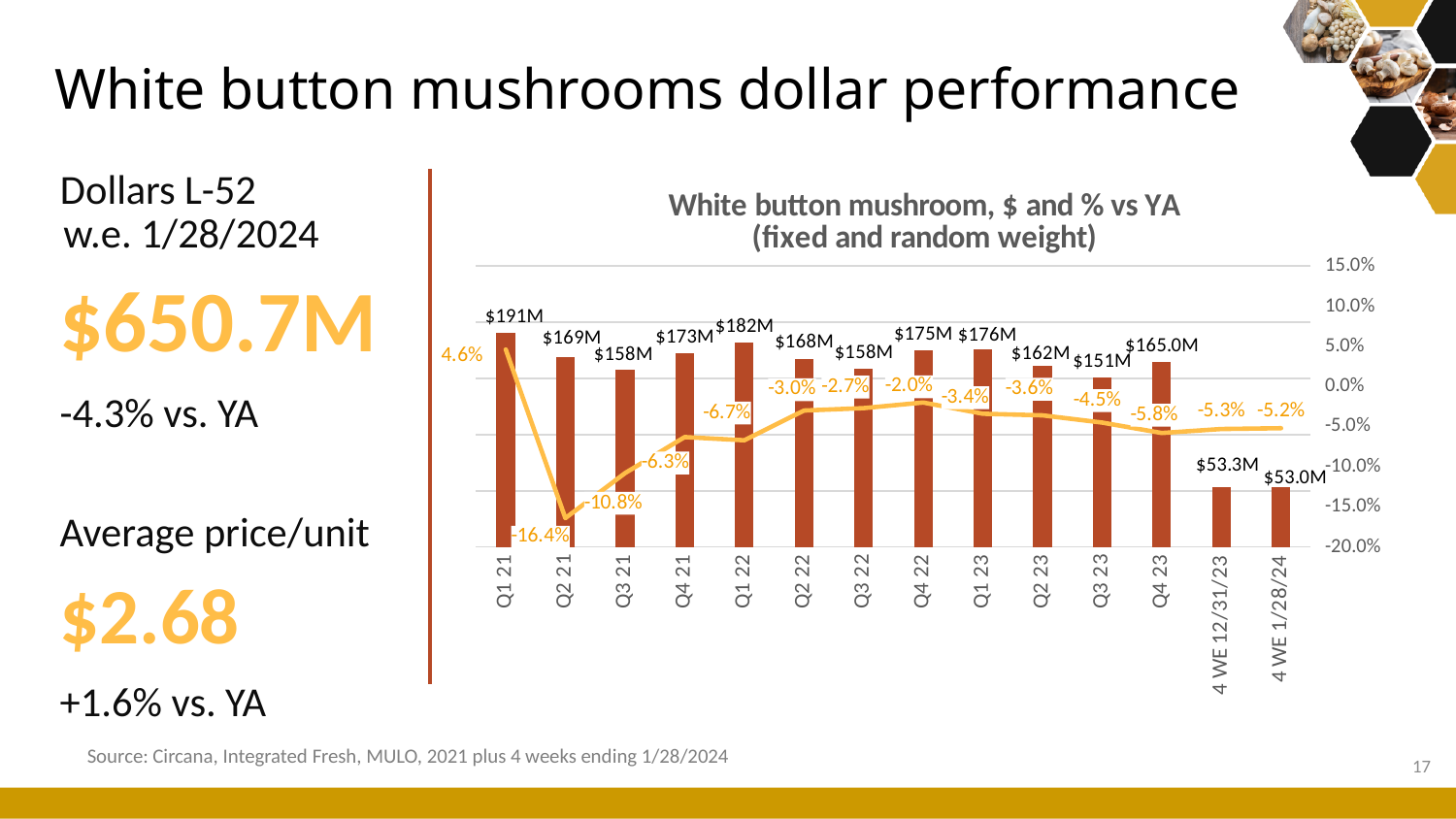
What is the dollar value for Q4 23 in the chart? $165.0M What is the title of the chart? White button mushroom, $ and % vs YA (fixed and random weight) What is the difference in dollar value between Q1 22 and Q2 22? $14M What is the % vs YA value for 4 WE 1/28/24 in the chart? -5.2% Which has a larger dollar value, Q4 22 or Q1 23? Q1 23 What is the dollar value for Q1 21 in the chart? $191M How many periods are shown on the x axis of the chart? 14 What is the % vs YA value for Q2 21 in the chart? -16.4% What kind of chart is shown on the slide? Combination bar and line chart Which period has the lowest % vs YA value in the chart? Q2 21 Does the % vs YA line rise or fall from Q2 21 to Q4 22? Rise Which period has the highest dollar value in the chart? Q1 21